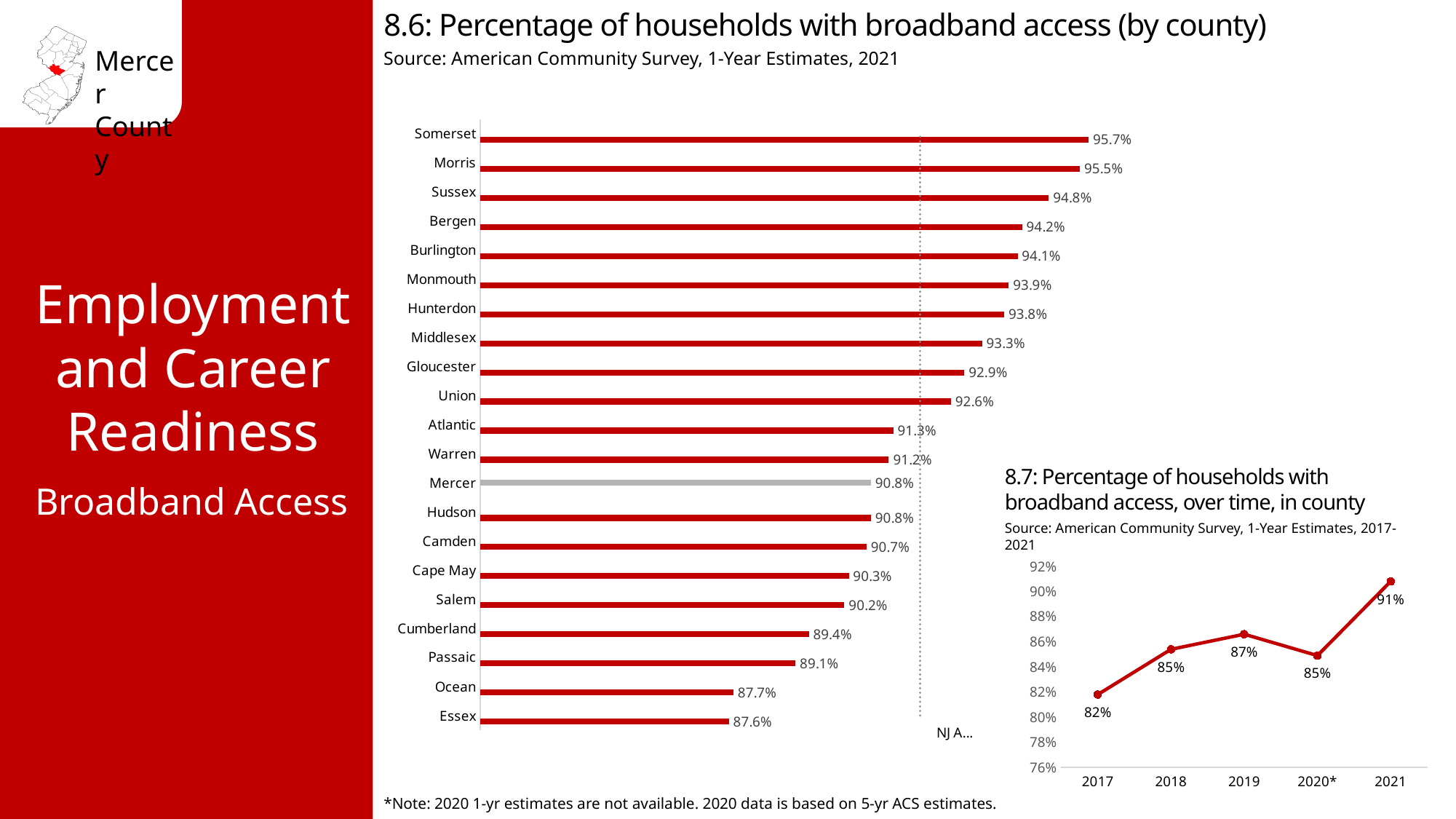
In chart 8.6 (broadband access by county), which is larger, the value for Bergen or the value for Ocean? Bergen In chart 8.6 (broadband access by county), what is the value for Essex? 87.6% In chart 8.7 (broadband access over time), which year has the lowest value? 2017 In chart 8.6 (broadband access by county), how many counties are shown? 21 In chart 8.6 (broadband access by county), which county has the highest percentage? Somerset What kind of chart is chart 8.6 (broadband access by county)? Bar chart In chart 8.7 (broadband access over time), what is the value for 2021? 91% In chart 8.6 (broadband access by county), what is the difference between Somerset and Mercer? 4.9% What kind of chart is chart 8.7 (broadband access over time)? Line chart In chart 8.6 (broadband access by county), which county has the lowest percentage? Essex In chart 8.7 (broadband access over time), what is the difference between 2021 and 2017? 9% In chart 8.6 (broadband access by county), what is the value for Mercer? 90.8%